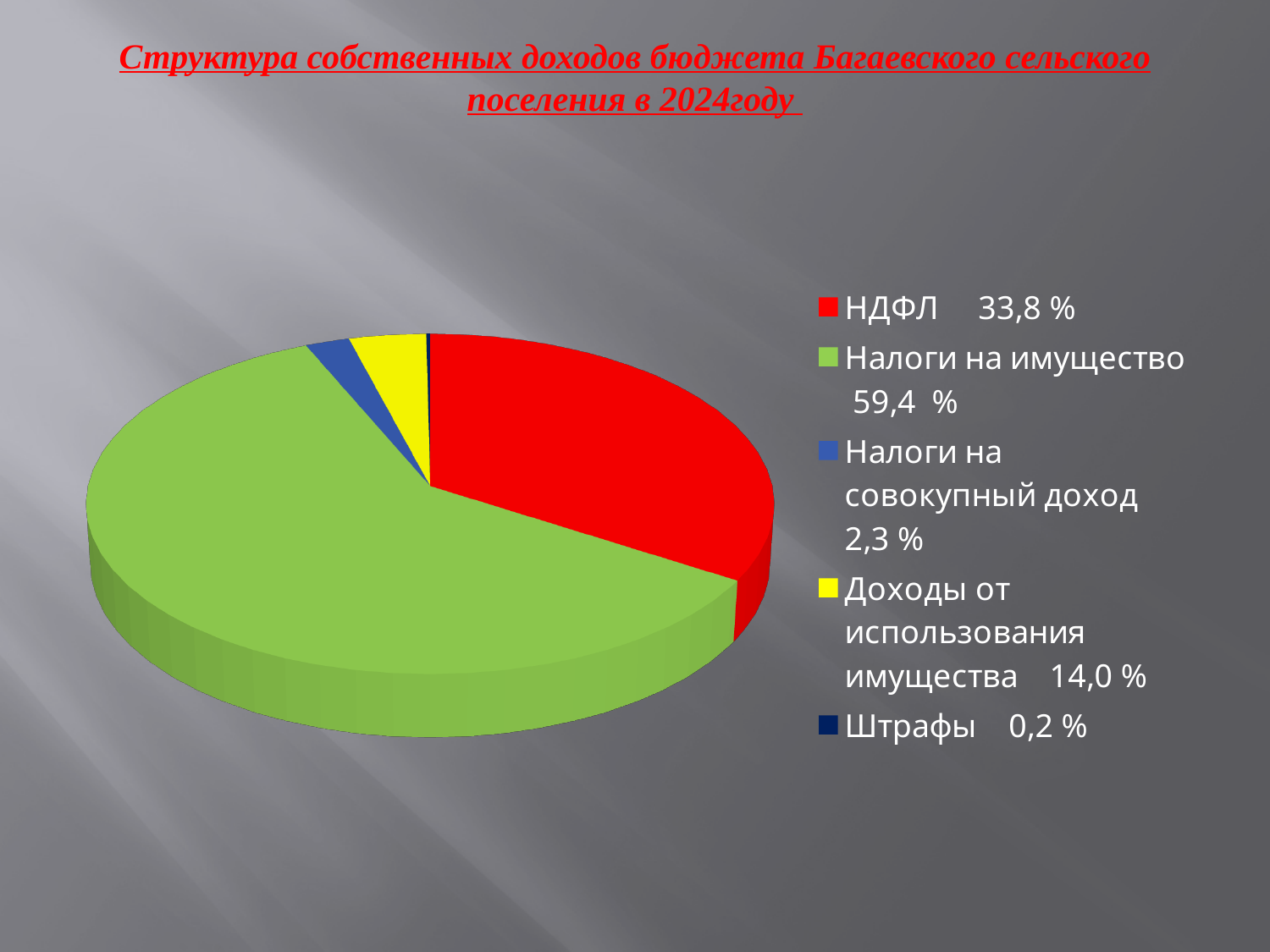
What share does Налоги на имущество have according to the legend? 59,4 % What kind of chart is shown on the slide? Pie chart What share does Штрафы have according to the legend? 0,2 % Which category has the largest share of the pie? Налоги на имущество What colour is the slice for Налоги на имущество? Green What share does НДФЛ have according to the legend? 33,8 % Which category has the smallest share of the pie? Штрафы What is the difference between the shares of Налоги на имущество and НДФЛ? 25,6 % How many categories does the legend list? 5 What share does Доходы от использования имущества have according to the legend? 14,0 % Which is larger, the share for НДФЛ or the share for Доходы от использования имущества? НДФЛ What share does Налоги на совокупный доход have according to the legend? 2,3 %